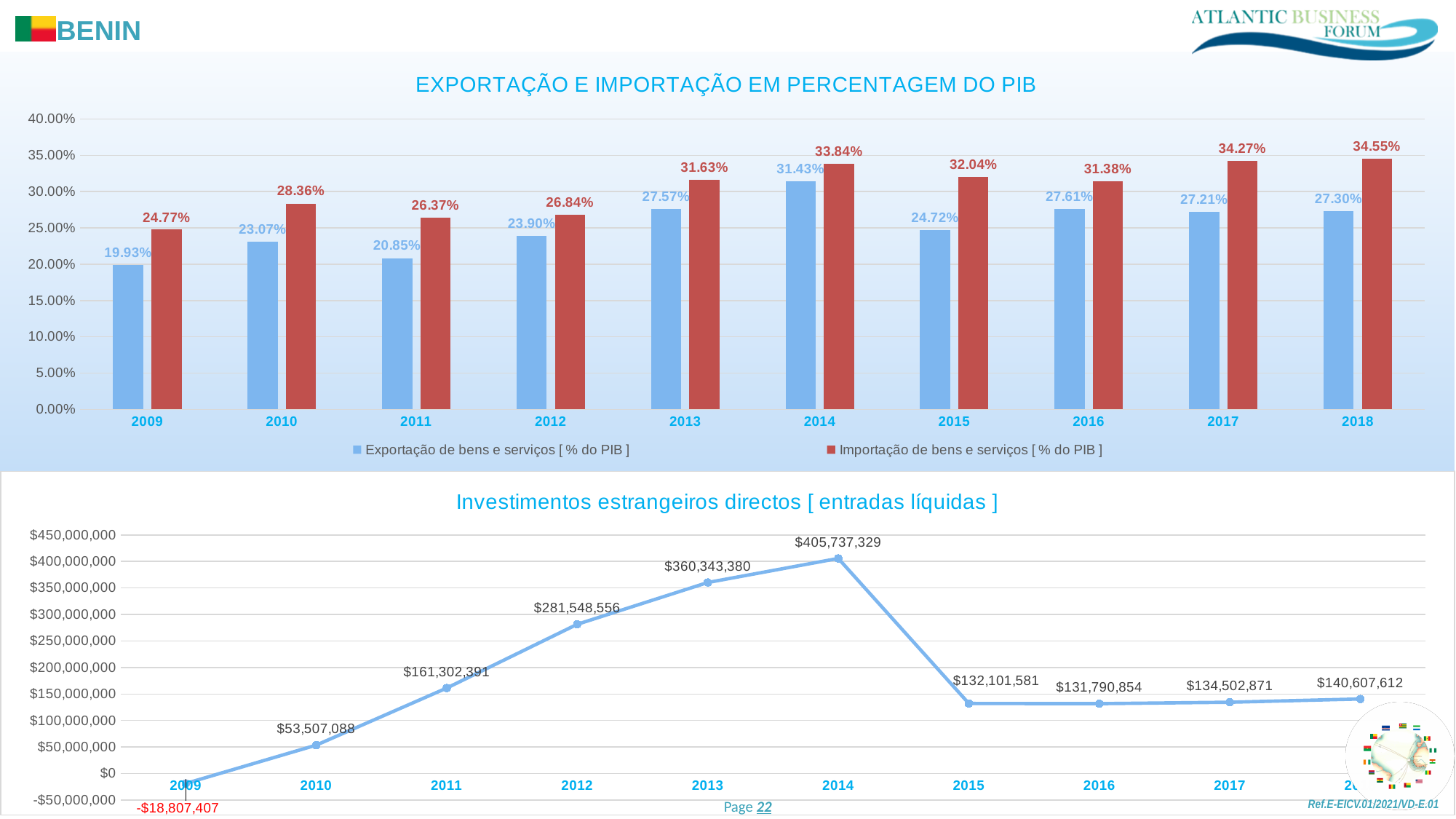
In the chart 'Investimentos estrangeiros directos [ entradas líquidas ]', what is the difference between the 2014 and 2013 values? $45,393,949 In the chart 'EXPORTAÇÃO E IMPORTAÇÃO EM PERCENTAGEM DO PIB', what is the value of Exportação de bens e serviços for 2014? 31.43% In the chart 'EXPORTAÇÃO E IMPORTAÇÃO EM PERCENTAGEM DO PIB', how many series does the legend list? 2 In the chart 'Investimentos estrangeiros directos [ entradas líquidas ]', which year has the highest value? 2014 In the chart 'Investimentos estrangeiros directos [ entradas líquidas ]', what is the value for 2009? -$18,807,407 In the chart 'EXPORTAÇÃO E IMPORTAÇÃO EM PERCENTAGEM DO PIB', which year has the highest Importação de bens e serviços value? 2018 In the chart 'EXPORTAÇÃO E IMPORTAÇÃO EM PERCENTAGEM DO PIB', what is the difference between Importação and Exportação in 2018? 7.25% In the chart 'Investimentos estrangeiros directos [ entradas líquidas ]', what is the value for 2012? $281,548,556 In the chart 'EXPORTAÇÃO E IMPORTAÇÃO EM PERCENTAGEM DO PIB', which year has the lowest Exportação de bens e serviços value? 2009 What kind of chart is 'EXPORTAÇÃO E IMPORTAÇÃO EM PERCENTAGEM DO PIB'? Bar chart In the chart 'Investimentos estrangeiros directos [ entradas líquidas ]', how many years are plotted on the x axis? 10 In the chart 'EXPORTAÇÃO E IMPORTAÇÃO EM PERCENTAGEM DO PIB', what is the value of Importação de bens e serviços for 2011? 26.37%